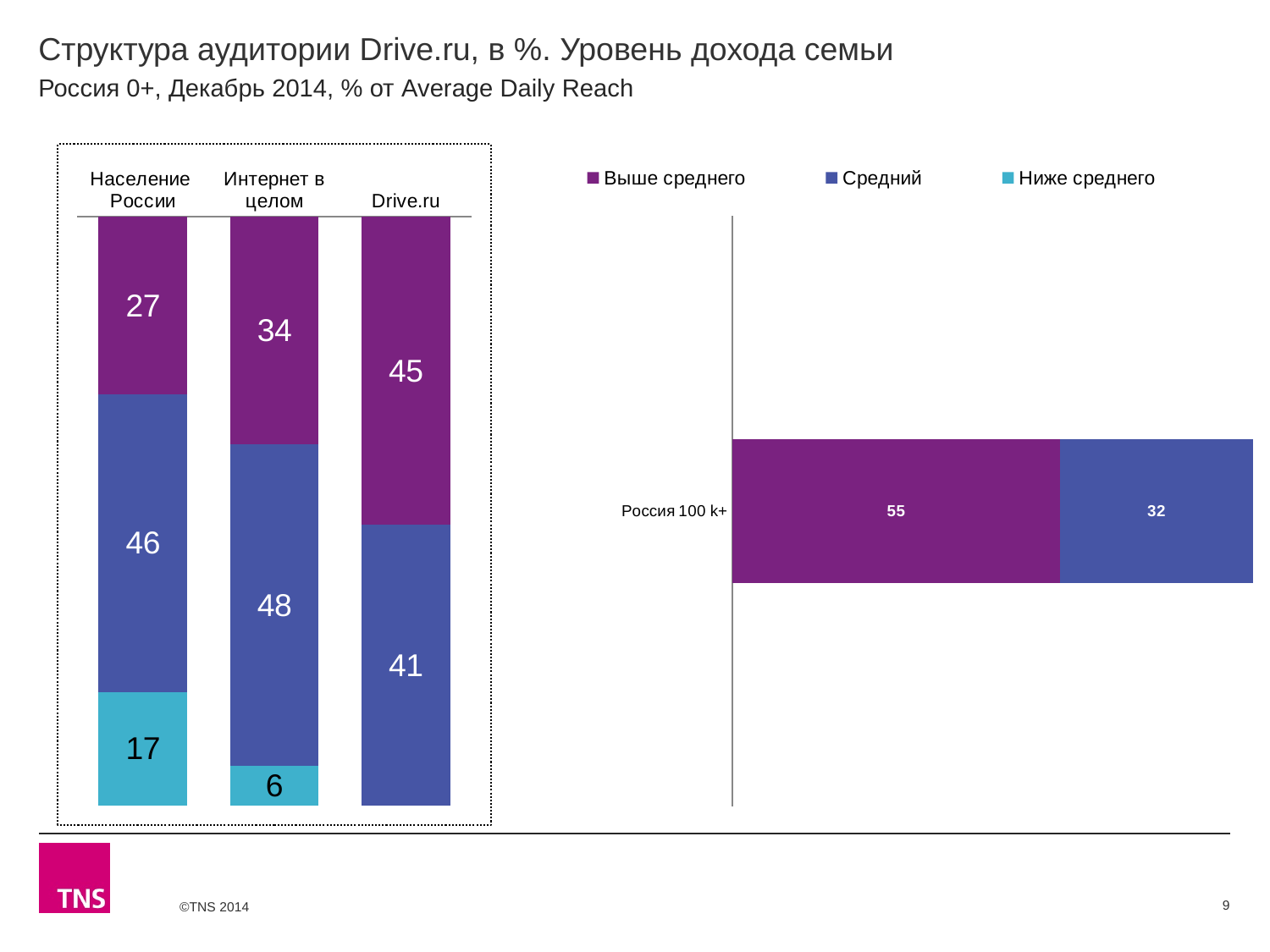
In the right chart, what is the 'Выше среднего' value for 'Россия 100 k+'? 55 In the left chart, what is the value of the 'Выше среднего' segment for Drive.ru? 45 In the left chart, what is the value of the 'Ниже среднего' segment for 'Интернет в целом'? 6 In the left chart, which category has the lowest 'Ниже среднего' value among those with a labelled segment? Интернет в целом In the left chart, which is larger: the 'Средний' value for 'Интернет в целом' or for Drive.ru? Интернет в целом In the left chart, which category has the highest 'Выше среднего' value? Drive.ru How many series does the legend list? 3 In the left chart, what is the value of the 'Средний' segment for 'Население России'? 46 In the left chart, what is the difference between the 'Выше среднего' values for Drive.ru and 'Население России'? 18 How many categories are shown in the left chart? 3 In the right chart, what is the difference between the 'Выше среднего' and 'Средний' values for 'Россия 100 k+'? 23 What kind of chart is the chart on the right? Stacked bar chart